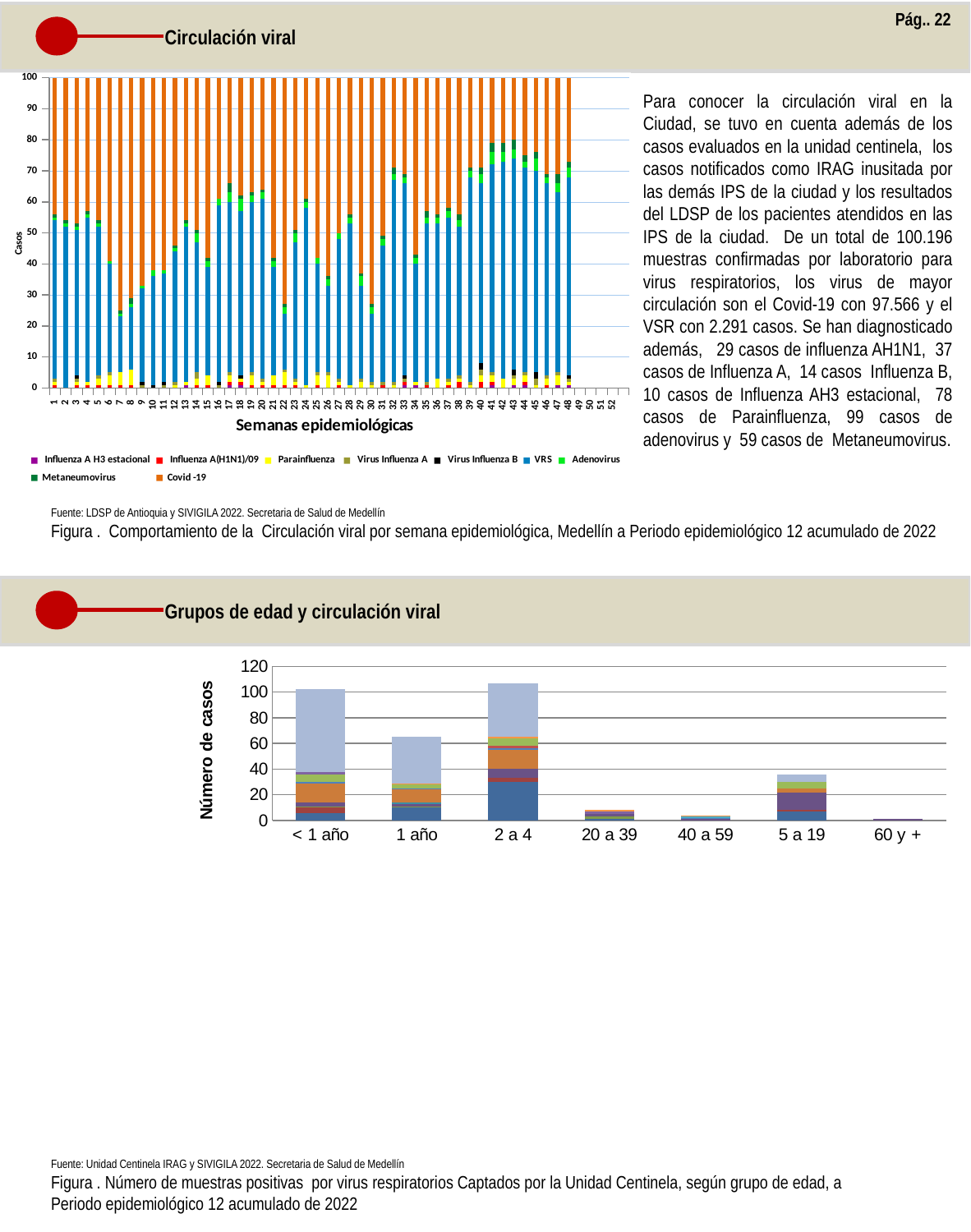
In the 'Circulación viral' chart, which series occupies the largest portion of the bar for week 7? Covid -19 In the 'Grupos de edad y circulación viral' chart, which has the larger total: '1 año' or '5 a 19'? 1 año In the 'Grupos de edad y circulación viral' chart, is the total for '2 a 4' greater or less than 100? greater How many series does the legend of the 'Circulación viral' chart list? 9 How many age-group categories are shown on the x axis of the 'Grupos de edad y circulación viral' chart? 7 In the 'Grupos de edad y circulación viral' chart, is the total for '5 a 19' greater or less than 20? greater In the 'Circulación viral' chart, is the VRS value for week 41 greater or less than 60? greater What is the x-axis title of the 'Circulación viral' chart? Semanas epidemiológicas In the 'Grupos de edad y circulación viral' chart, which age group has the lowest total number of cases? 60 y + What kind of chart is the 'Circulación viral' chart at the top of the slide? Stacked bar chart What kind of chart is the 'Grupos de edad y circulación viral' chart at the bottom of the slide? Stacked bar chart